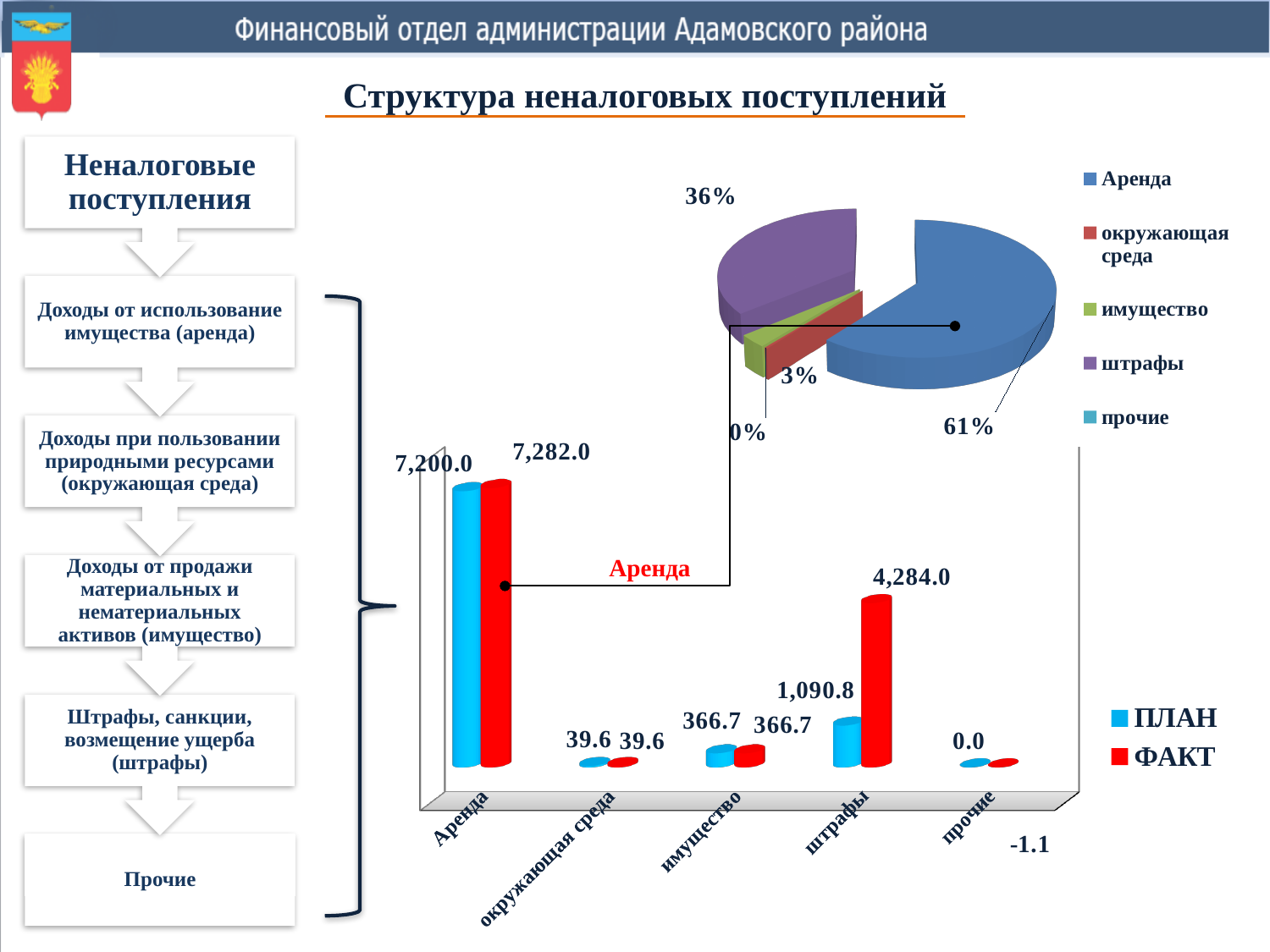
In the bar chart, what is the ПЛАН value for имущество? 366.7 In the bar chart, which category has the lowest ПЛАН value? прочие In the bar chart, what is the ФАКТ value for прочие? -1.1 In the bar chart, which category has the highest ФАКТ value? Аренда In the pie chart, what share is shown for Аренда? 61% In the bar chart, what is the ПЛАН value for штрафы? 1,090.8 In the bar chart, which is larger for Аренда: the ПЛАН value or the ФАКТ value? ФАКТ In the bar chart, what is the ФАКТ value for Аренда? 7,282.0 How many categories are shown on the x axis of the bar chart? 5 How many series does the legend of the bar chart list? 2 In the pie chart, what share is shown for штрафы? 36% In the bar chart, what is the difference between the ФАКТ and ПЛАН values for штрафы? 3,193.2